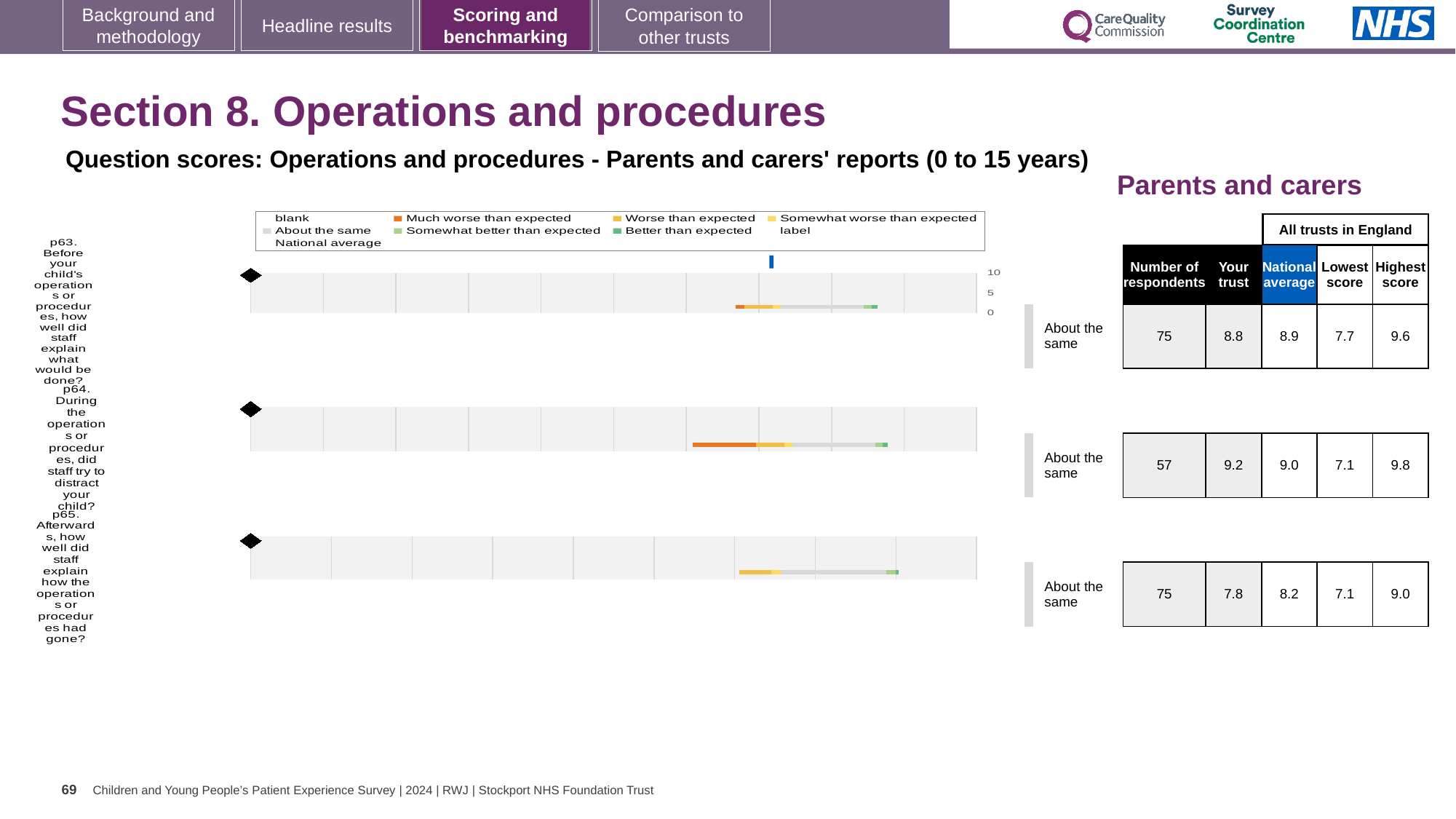
How many entries does the chart legend list? 9 What is the National average score for p63 (Before your child's operations or procedures, how well did staff explain what would be done?)? 8.9 What colour does the legend use for 'Much worse than expected'? orange For p64, which is larger: the 'Your trust' score or the National average? Your trust What is the 'Your trust' score for p64 (During the operations or procedures, did staff try to distract your child?)? 9.2 For p65, what is the difference between the Highest score and the Lowest score across all trusts in England? 1.9 How many questions (p63, p64, p65) are plotted in the chart? 3 What kind of chart is used to show the question scores for Operations and procedures? bar chart Which question has the lowest 'Your trust' score? p65 How many respondents answered p65 (Afterwards, how well did staff explain how the operations or procedures had gone?)? 75 Which question has the highest 'Your trust' score? p64 What benchmark category is shown for all three questions in this section? About the same